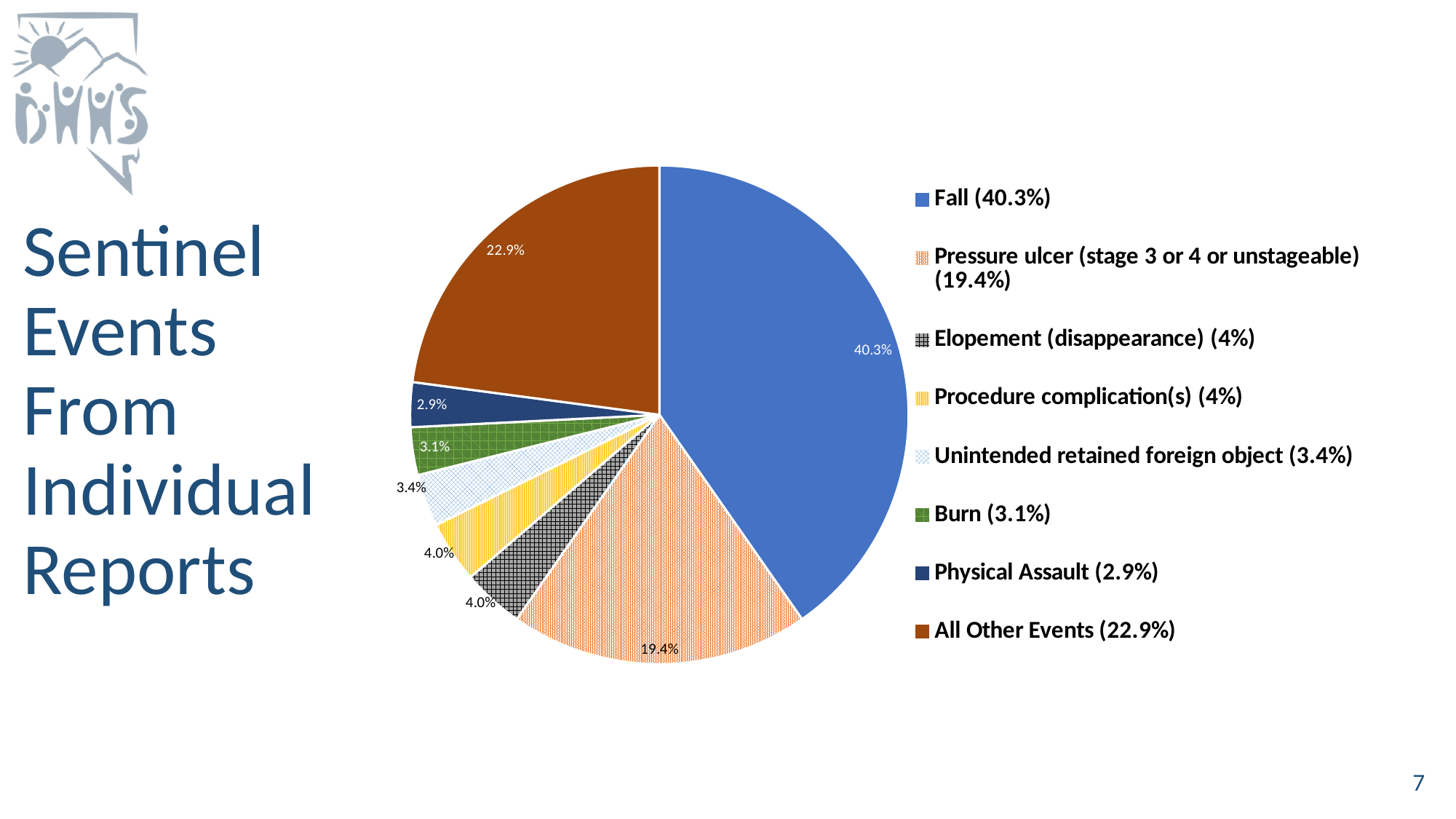
Which category has the smallest slice of the pie? Physical Assault What type of chart is shown on the slide? pie chart Which is larger, the slice for Unintended retained foreign object or the slice for Burn? Unintended retained foreign object What share of the pie does Fall account for? 40.3% What percentage is shown for All Other Events? 22.9% What percentage is shown for Physical Assault? 2.9% What percentage is shown for Pressure ulcer (stage 3 or 4 or unstageable)? 19.4% What is the difference in percentage points between Fall and All Other Events? 17.4 Which category has the largest slice of the pie? Fall How many categories does the legend list? 8 Which two categories share the same percentage of 4%? Elopement (disappearance) and Procedure complication(s) What percentage is shown for Burn? 3.1%